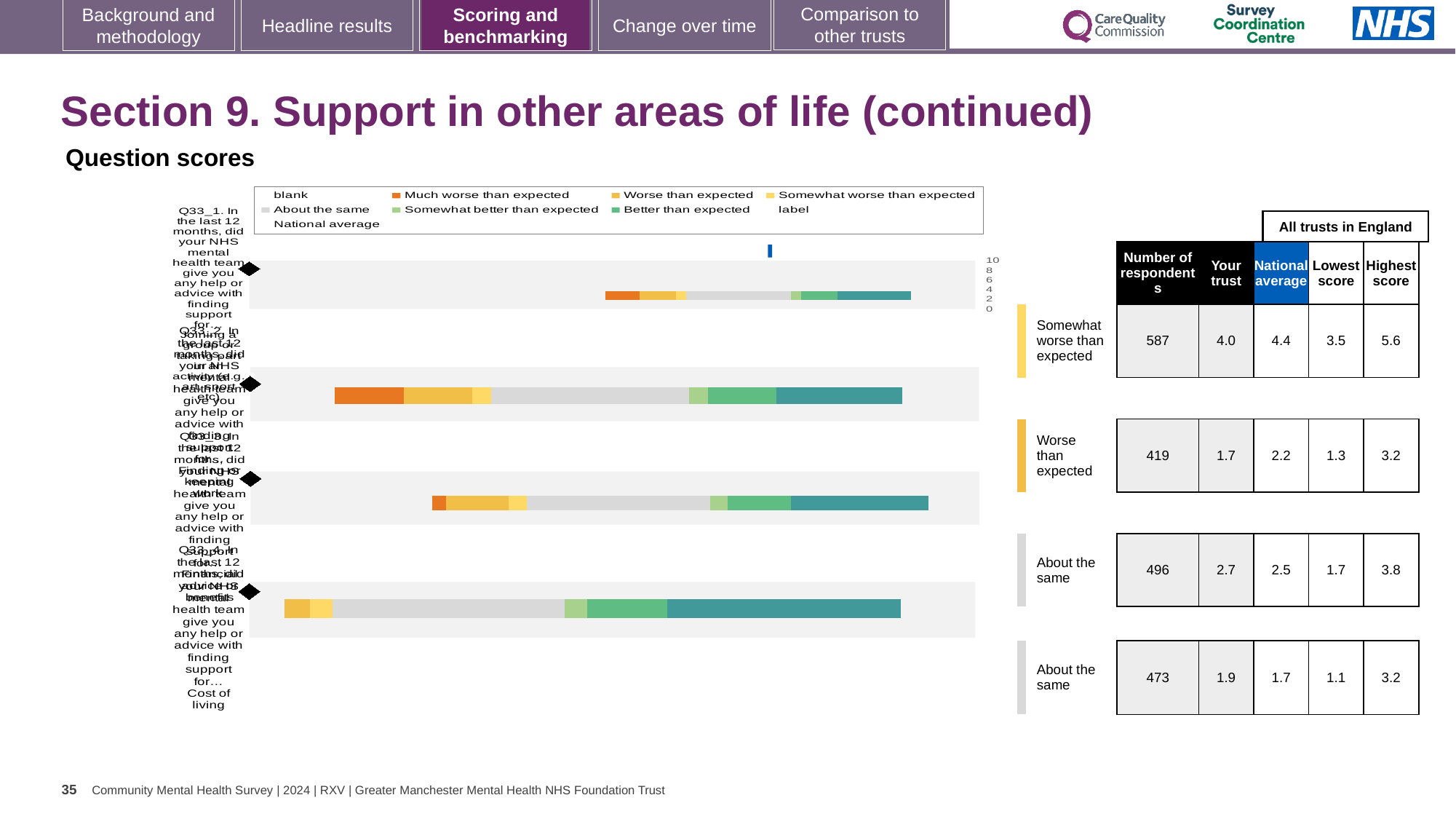
What kind of chart is shown on the slide? Bar chart In the table beside the chart, what is the 'Your trust' score for the row rated 'Worse than expected'? 1.7 How many question bars are plotted in the chart? 4 In the table beside the chart, what is the highest score for the last question row? 3.2 What colour represents 'Much worse than expected' in the chart legend? Orange In the table beside the chart, what is the difference between the national average and the 'Your trust' score for the first question row? 0.4 In the table beside the chart, what is the national average for the first question row? 4.4 How many entries does the chart legend list? 9 In the table beside the chart, for the third question row, which is larger: the 'Your trust' score or the national average? Your trust What heading appears directly above the chart? Question scores In the table beside the chart, how many respondents are listed for the first question row (rated 'Somewhat worse than expected')? 587 In the table beside the chart, which question row has the highest number of respondents? The first row (587)